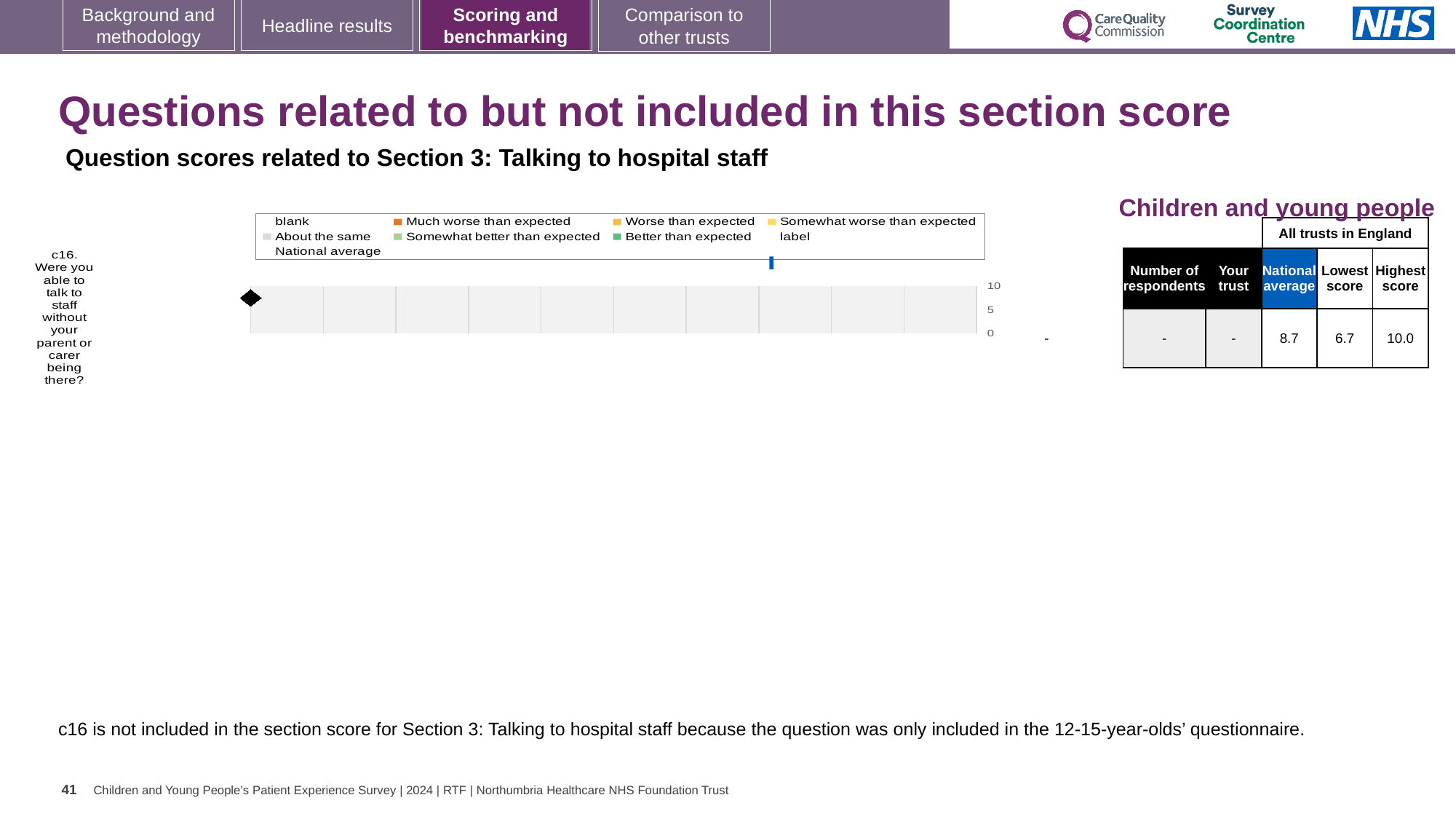
What is the difference between the Highest score and the Lowest score shown in the table for c16? 3.3 What value is shown for 'Your trust' in the table for c16? - In the table next to the chart, what is the Highest score across all trusts in England for c16? 10.0 How many question categories are plotted on the chart? 1 What is the highest value shown on the chart's value axis? 10 In the table next to the chart, what is the National average score for c16? 8.7 What kind of chart is shown on the slide? bar chart Which question is shown on the chart's category axis? c16. Were you able to talk to staff without your parent or carer being there? Which is larger for c16, the National average or the Lowest score? National average In the table next to the chart, what is the Lowest score across all trusts in England for c16? 6.7